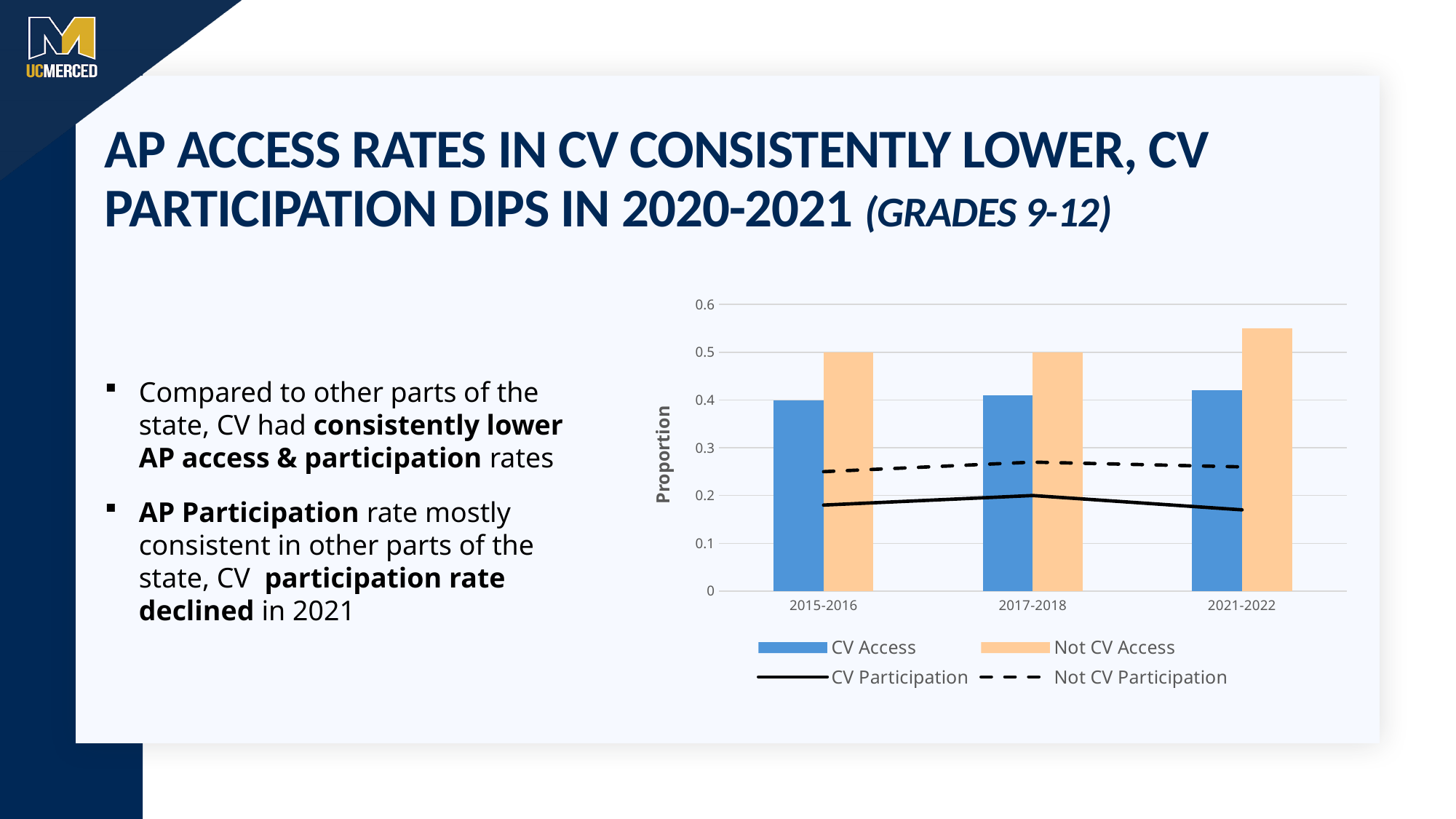
Is the Not CV Access value for 2021-2022 greater or less than 0.5? greater What kind of chart is shown on the slide? A combined bar and line chart What is the label on the chart's y axis? Proportion Is the CV Participation value for 2021-2022 greater or less than 0.2? less Does the CV Access series rise or fall from 2015-2016 to 2021-2022? Rises What is the Not CV Access value for 2015-2016? 0.5 In 2021-2022, which is larger: CV Access or Not CV Access? Not CV Access In which school year is the Not CV Access bar highest? 2021-2022 In which school year is the CV Participation line at its lowest? 2021-2022 How many school-year categories are shown on the x axis? 3 How many series does the chart legend list? 4